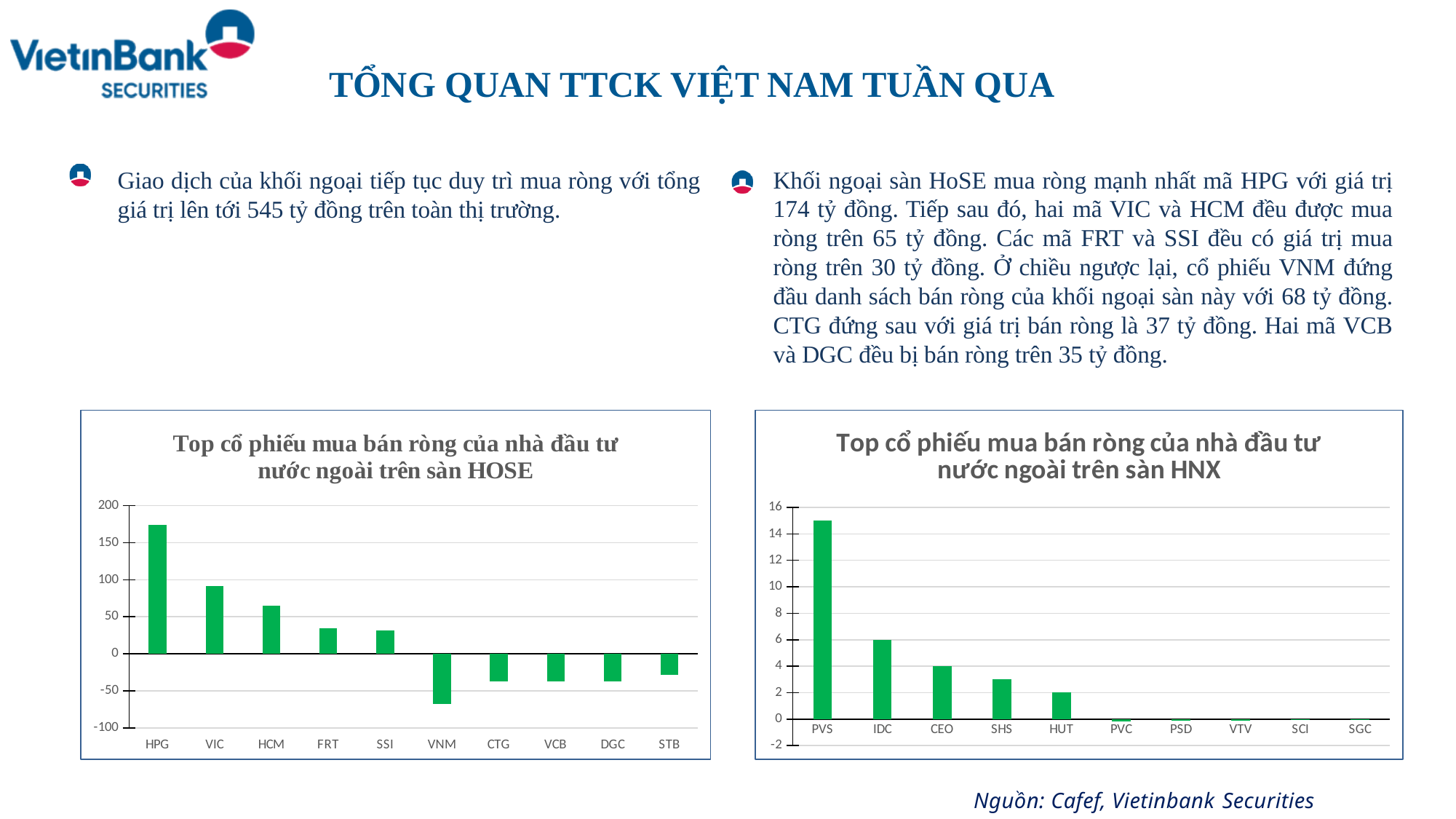
In the HOSE chart, is the value for HPG greater or less than 150? greater In the HOSE chart, which stock has the lowest value? VNM In the HOSE chart, is the value for VIC greater or less than 100? less How many stocks are shown in the HOSE chart? 10 What kind of chart is the 'Top cổ phiếu mua bán ròng của nhà đầu tư nước ngoài trên sàn HOSE' chart? Bar chart In the HNX chart, what is the value for IDC? 6 In the HNX chart, which stock has the highest value? PVS In the HNX chart, do the values rise or fall from left to right along the x axis? fall In the HOSE chart, is the value for VNM greater or less than -50? less In the HOSE chart, which is larger, the value for HPG or the value for VIC? HPG In the HOSE chart, which stock has the highest value? HPG